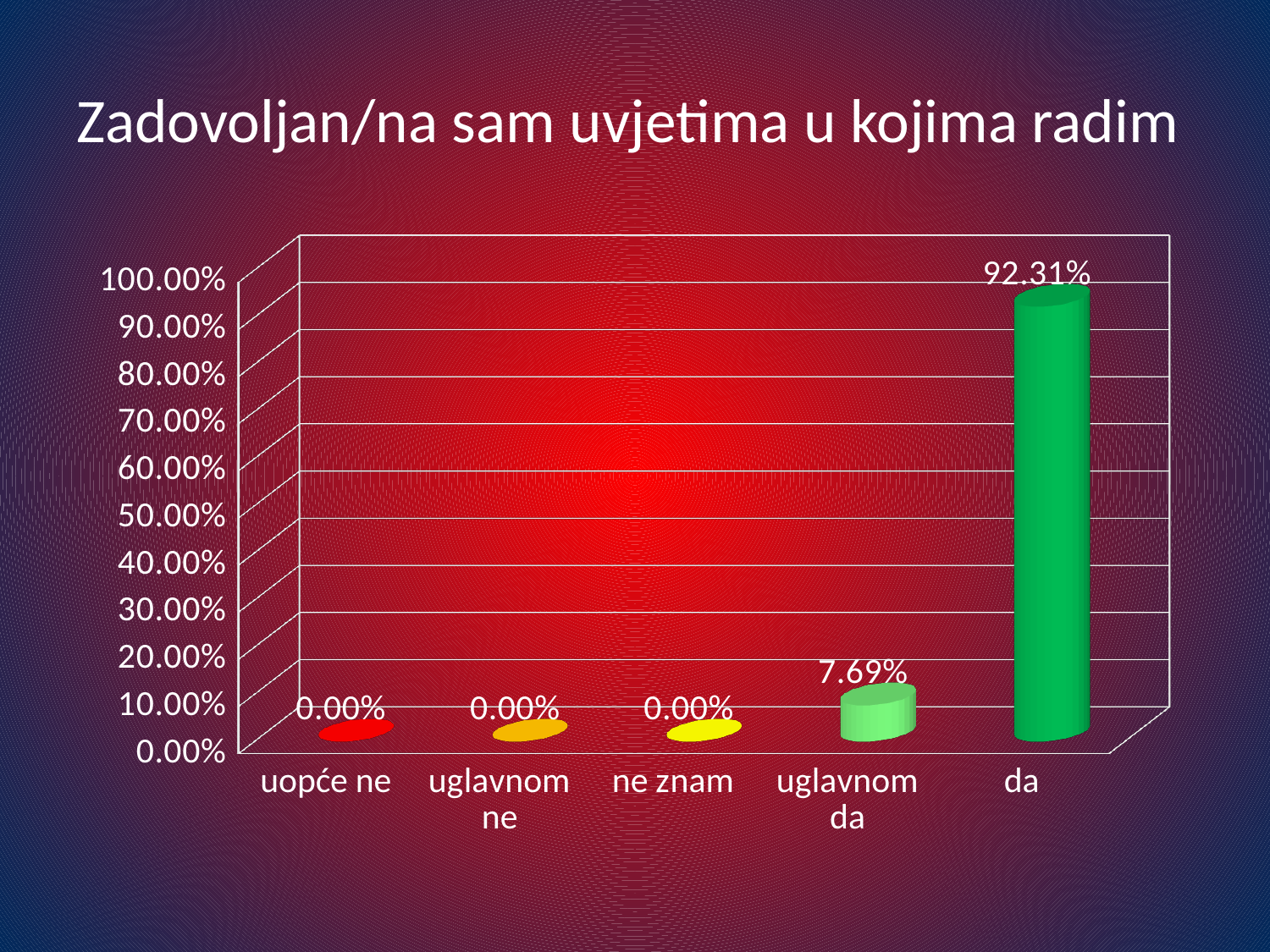
What is the value for "da"? 92.31% How many categories are shown on the x axis? 5 What is the difference between the values for "da" and "uglavnom da"? 84.62% Is the value for "da" greater or less than 90.00%? greater What is the value for "ne znam"? 0.00% How many categories have a value of 0.00%? 3 What is the value for "uglavnom da"? 7.69% Which is larger, the value for "uglavnom da" or the value for "uglavnom ne"? uglavnom da What is the title of the slide? Zadovoljan/na sam uvjetima u kojima radim Is the value for "uglavnom da" greater or less than 10.00%? less Which category has the highest value? da What kind of chart is shown on the slide? bar chart